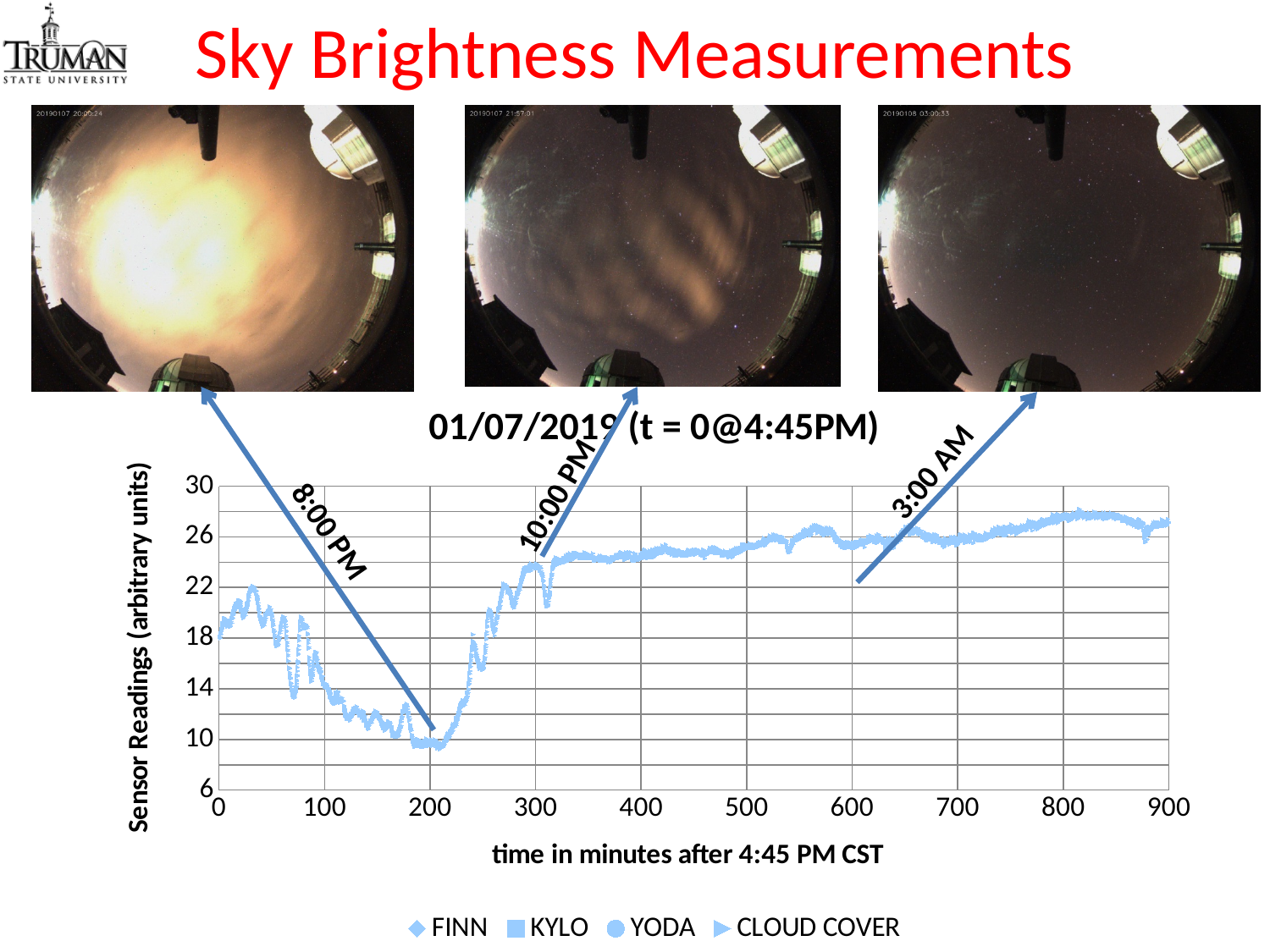
Which is larger, the sensor reading at 200 minutes or at 600 minutes? 600 minutes Is the sensor reading at 400 minutes greater or less than 18? greater Which is larger, the sensor reading at 100 minutes or at 300 minutes? 300 minutes Is the sensor reading at 200 minutes greater or less than 14? less Do the sensor readings rise or fall between 200 and 300 minutes? rise Is the sensor reading at 600 minutes greater or less than 22? greater Do the sensor readings rise or fall between 0 and 200 minutes? fall How many series does the chart legend list? 4 What is the title of the chart? 01/07/2019 (t = 0@4:45PM) What kind of chart is shown on the slide: a bar chart, a pie chart, or a line chart? line chart What is the label of the chart's x axis? time in minutes after 4:45 PM CST